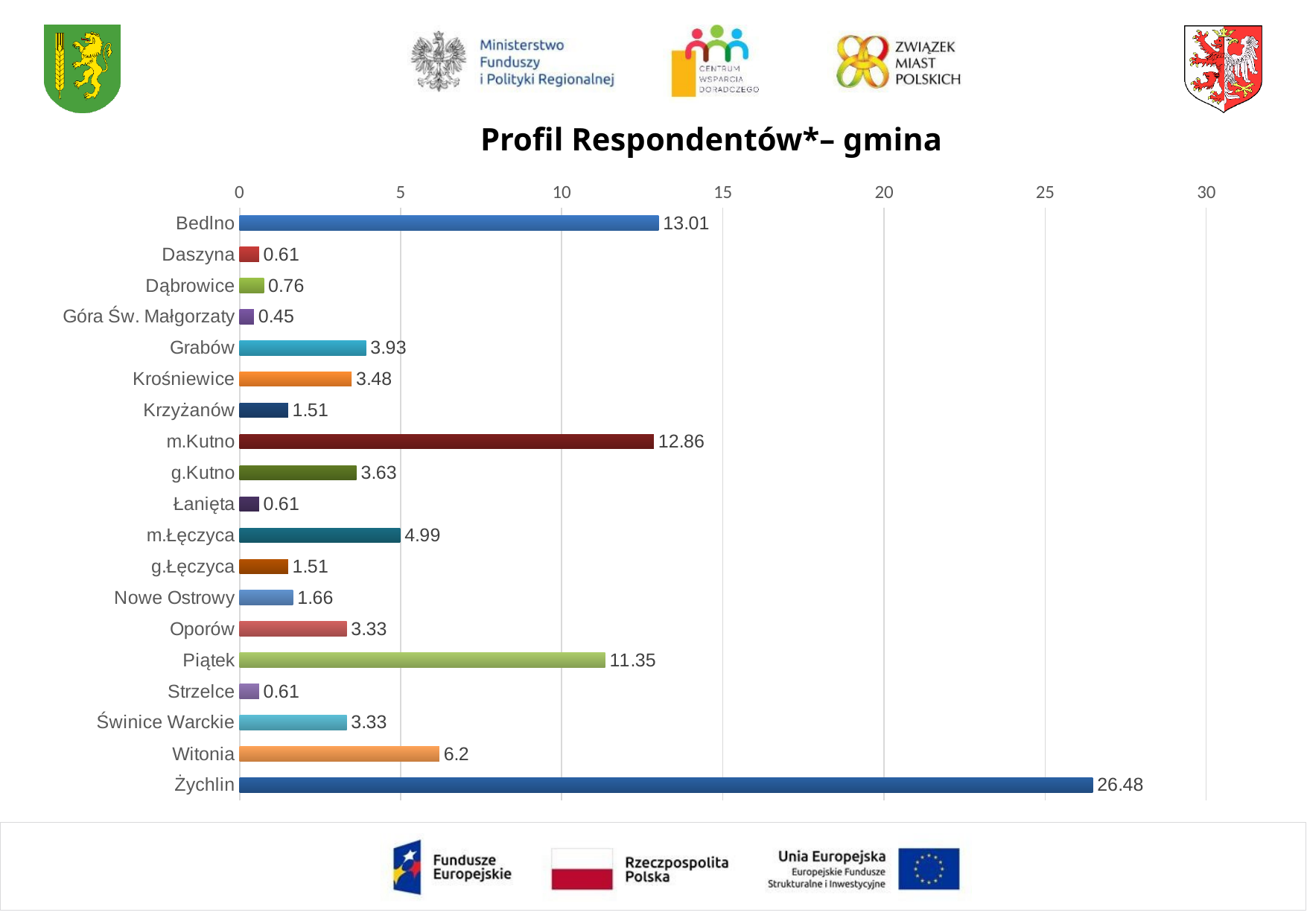
What is the value for Żychlin? 26.48 What is the difference between the values for Witonia and m.Łęczyca? 1.21 Is the value for m.Kutno greater or less than 10? greater Which gmina has the lowest value? Góra Św. Małgorzaty How many gminas are shown on the chart? 19 What is the value for Witonia? 6.2 What is the value for Piątek? 11.35 Which gmina has the highest value? Żychlin What type of chart is shown on the slide? Bar chart What is the value for Bedlno? 13.01 What is the difference between the values for Żychlin and Bedlno? 13.47 Which has a larger value, Grabów or Krośniewice? Grabów